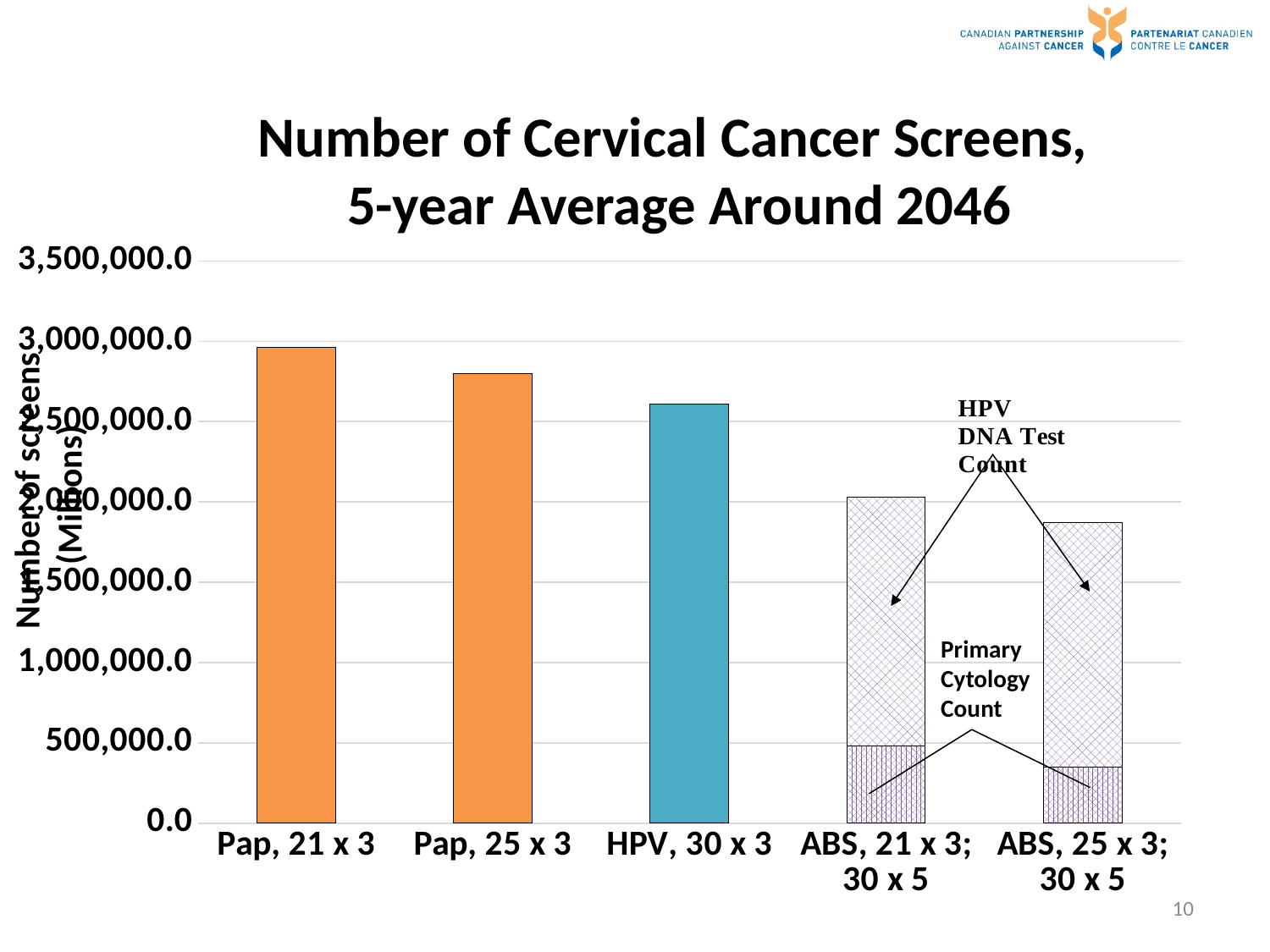
Is the total value for ABS, 25 x 3; 30 x 5 greater or less than 2,000,000.0? less Is the value for Pap, 21 x 3 greater or less than 2,500,000.0? greater Is the Primary Cytology Count portion of the ABS, 25 x 3; 30 x 5 bar greater or less than 500,000.0? less Do the bar heights rise or fall moving from left to right across the x axis? Fall What is the label on the y axis of the chart? Number of screens (Millions) Which has more screens, Pap, 21 x 3 or HPV, 30 x 3? Pap, 21 x 3 Which category has the lowest total number of cervical cancer screens? ABS, 25 x 3; 30 x 5 Which category has the highest number of cervical cancer screens? Pap, 21 x 3 How many screening strategy categories are shown on the x axis? 5 What kind of chart is shown on the slide? Bar chart